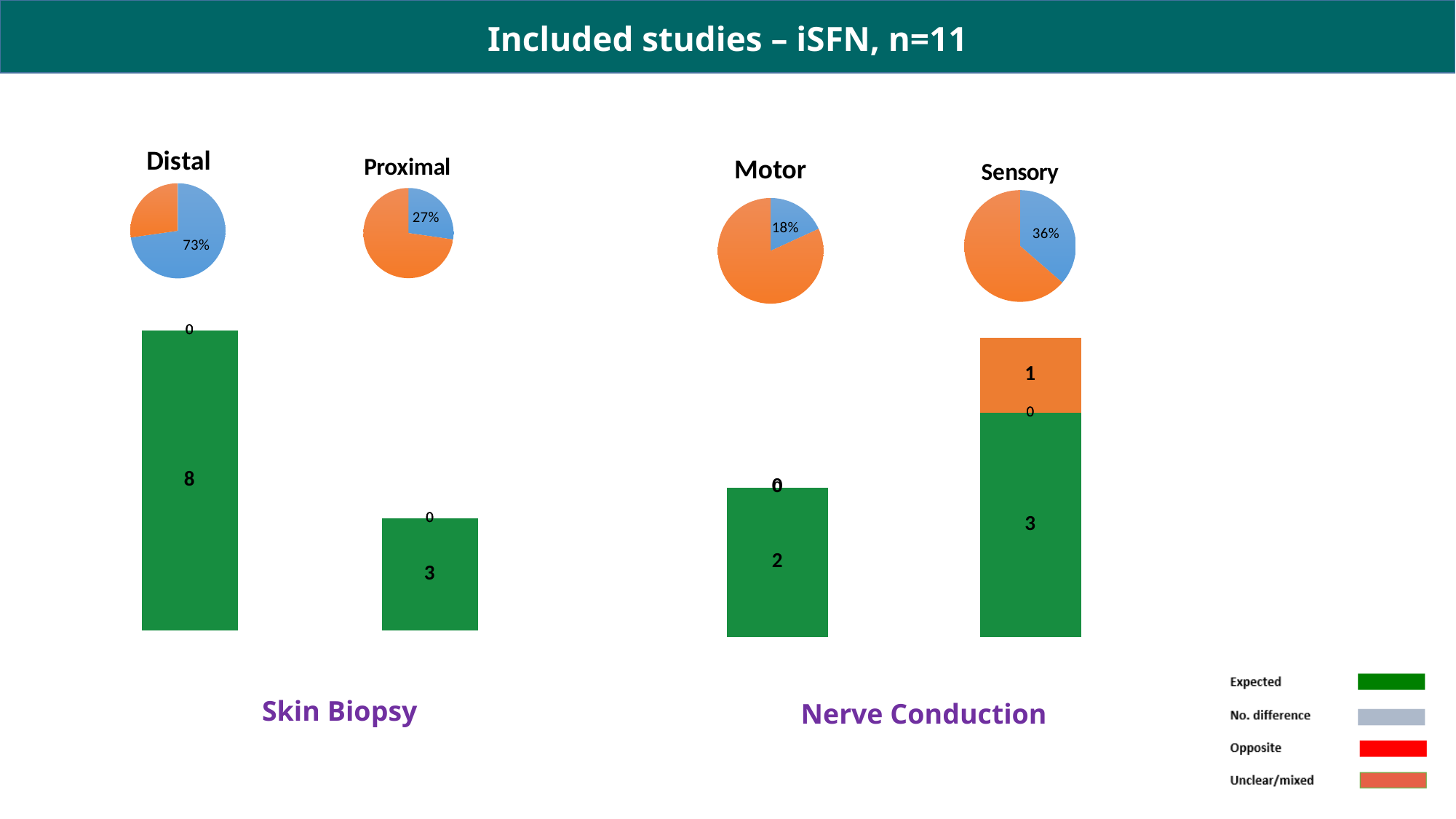
How many entries does the legend at the bottom right list? 4 In the Motor pie chart, what percentage is labelled on the blue slice? 18% In the Distal pie chart, what percentage is shown for the blue slice? 73% In the Sensory pie chart, what percentage is labelled on the blue slice? 36% In the Distal bar chart, what is the value of the Expected (green) segment? 8 What is the difference between the Expected value in the Distal bar chart and the Expected value in the Proximal bar chart? 5 Across the four bar charts, which category has the highest Expected value? Distal In the Motor bar chart, what is the value of the Expected (green) segment? 2 In the Sensory bar chart, what is the total of the stacked bar? 4 In the Sensory bar chart, what is the value of the Unclear/mixed (orange) segment? 1 In the Proximal bar chart, what is the value of the Expected (green) segment? 3